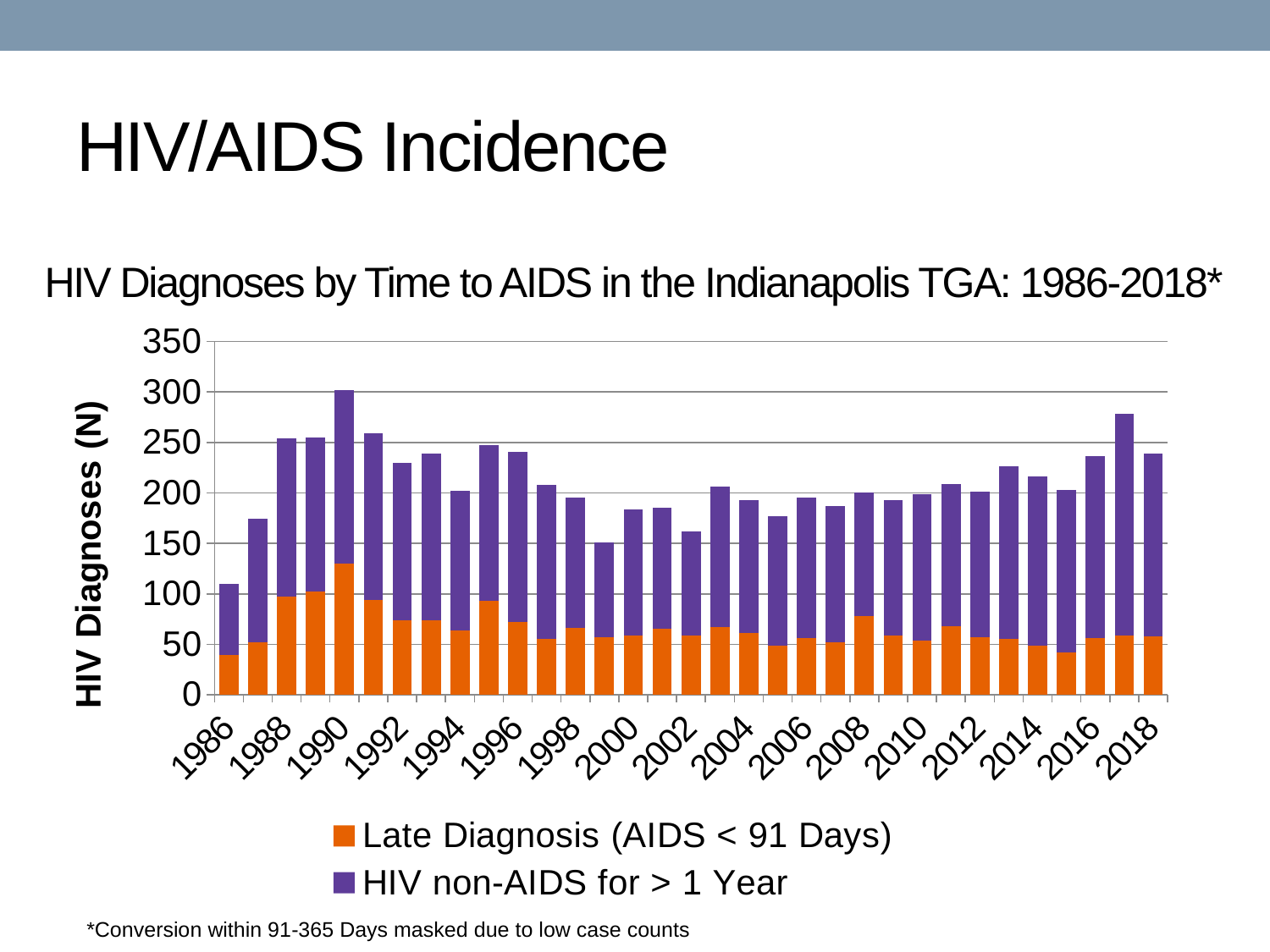
Which year has the highest total number of HIV diagnoses? 1990 Is the Late Diagnosis (AIDS < 91 Days) value for 1990 greater or less than 100? greater How many years (bars) are plotted on the x axis? 33 Is the total number of HIV diagnoses in 1999 greater or less than 200? less Which year has a higher total of HIV diagnoses, 1986 or 1987? 1987 Which series is shown in orange in the legend? Late Diagnosis (AIDS < 91 Days) What kind of chart is shown on the slide? Stacked bar chart Which year has the lowest total number of HIV diagnoses? 1986 Do the total HIV diagnoses rise or fall from 1986 to 1990? rise Is the total number of HIV diagnoses in 1986 greater or less than 150? less How many series does the legend list? 2